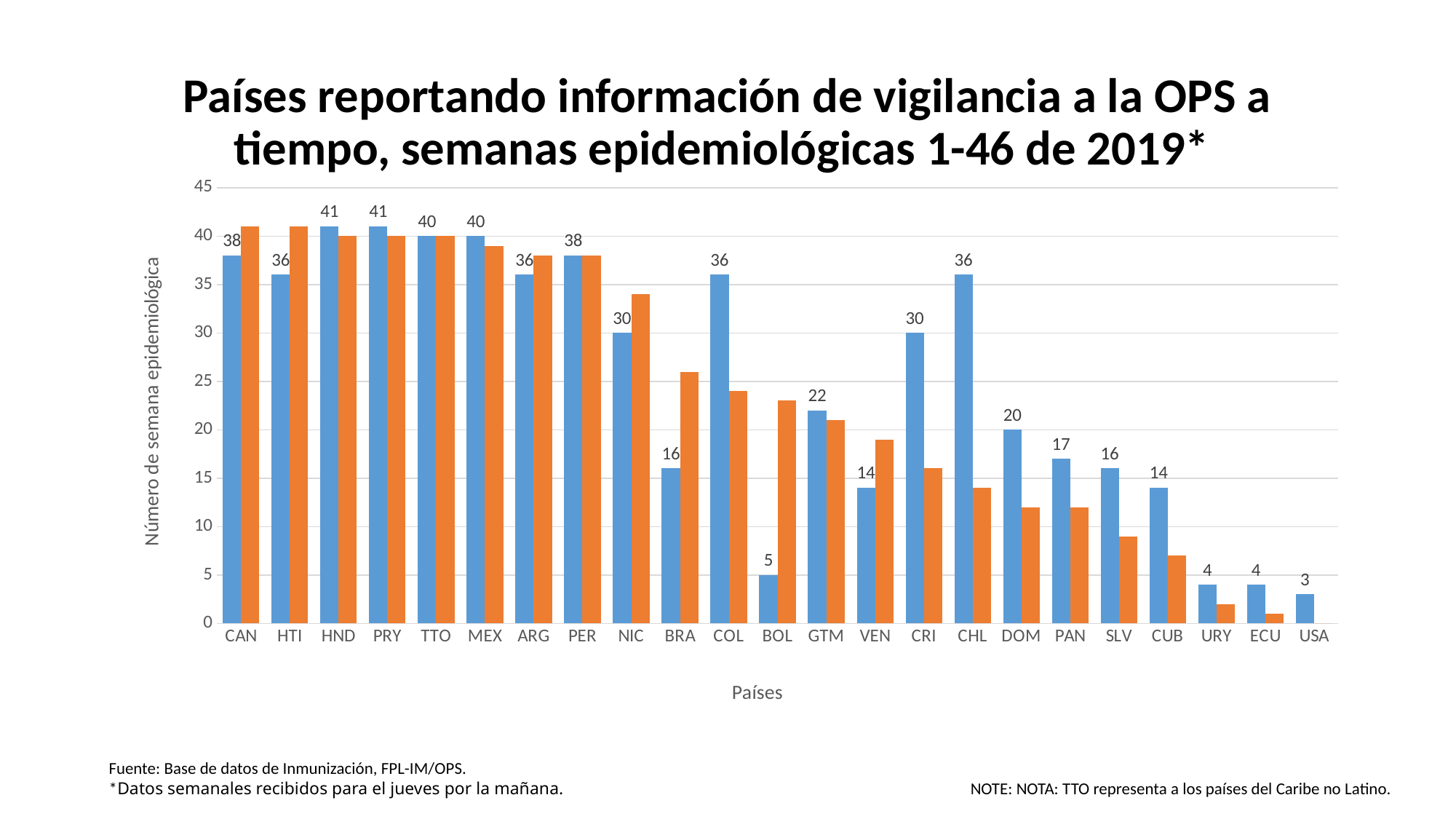
What kind of chart is shown on the slide? Bar chart Is the orange bar for BRA greater or less than 20? greater What is the title of the vertical axis? Número de semana epidemiológica Which has a larger blue bar value, DOM or PAN? DOM Which country has the lowest blue bar value? USA Which countries have the highest blue bar value? HND and PRY Is the orange bar for CHL greater or less than 20? less What is the title of the horizontal axis? Países What is the difference between the blue bar values for CRI and VEN? 16 What is the value of the blue bar for GTM? 22 What is the value of the blue bar for BOL? 5 How many countries are shown on the x axis? 23